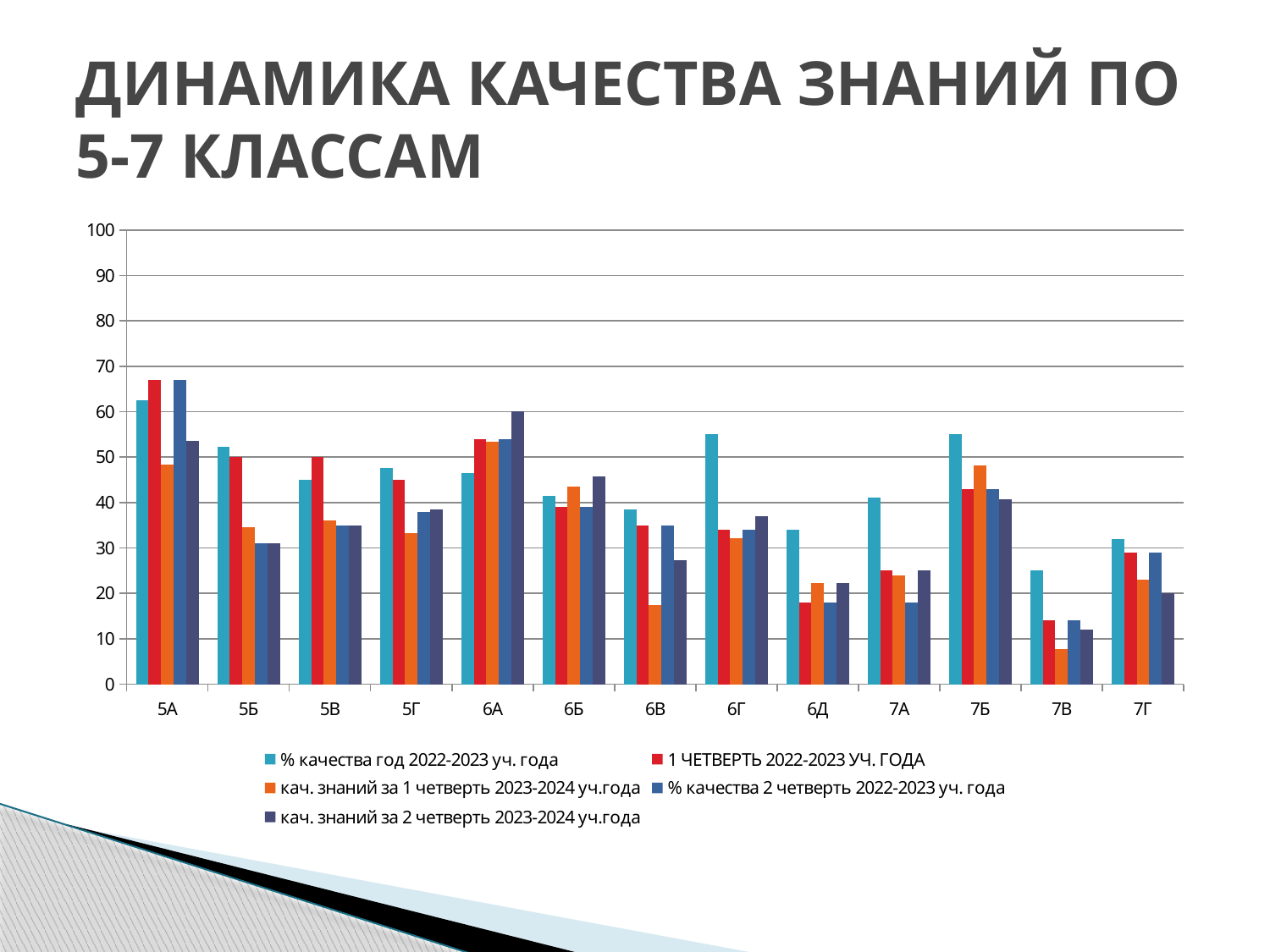
How many classes (categories) are shown on the x axis? 13 Which class has the highest value in the series "% качества год 2022-2023 уч. года"? 5А Is the value for 6В in the series "кач. знаний за 1 четверть 2023-2024 уч.года" greater or less than 20? less Which class has the lowest value in the series "% качества год 2022-2023 уч. года"? 7В In the series "кач. знаний за 1 четверть 2023-2024 уч.года", which is larger: the value for 7Б or for 7В? 7Б Is the value for 7В in the series "кач. знаний за 1 четверть 2023-2024 уч.года" greater or less than 10? less What is the title of the slide? ДИНАМИКА КАЧЕСТВА ЗНАНИЙ ПО 5-7 КЛАССАМ How many series does the legend list? 5 Is the value for 5А in the series "1 ЧЕТВЕРТЬ 2022-2023 УЧ. ГОДА" greater or less than 60? greater In the series "1 ЧЕТВЕРТЬ 2022-2023 УЧ. ГОДА", which is larger: the value for 5А or for 5Б? 5А What kind of chart is shown on the slide? bar chart